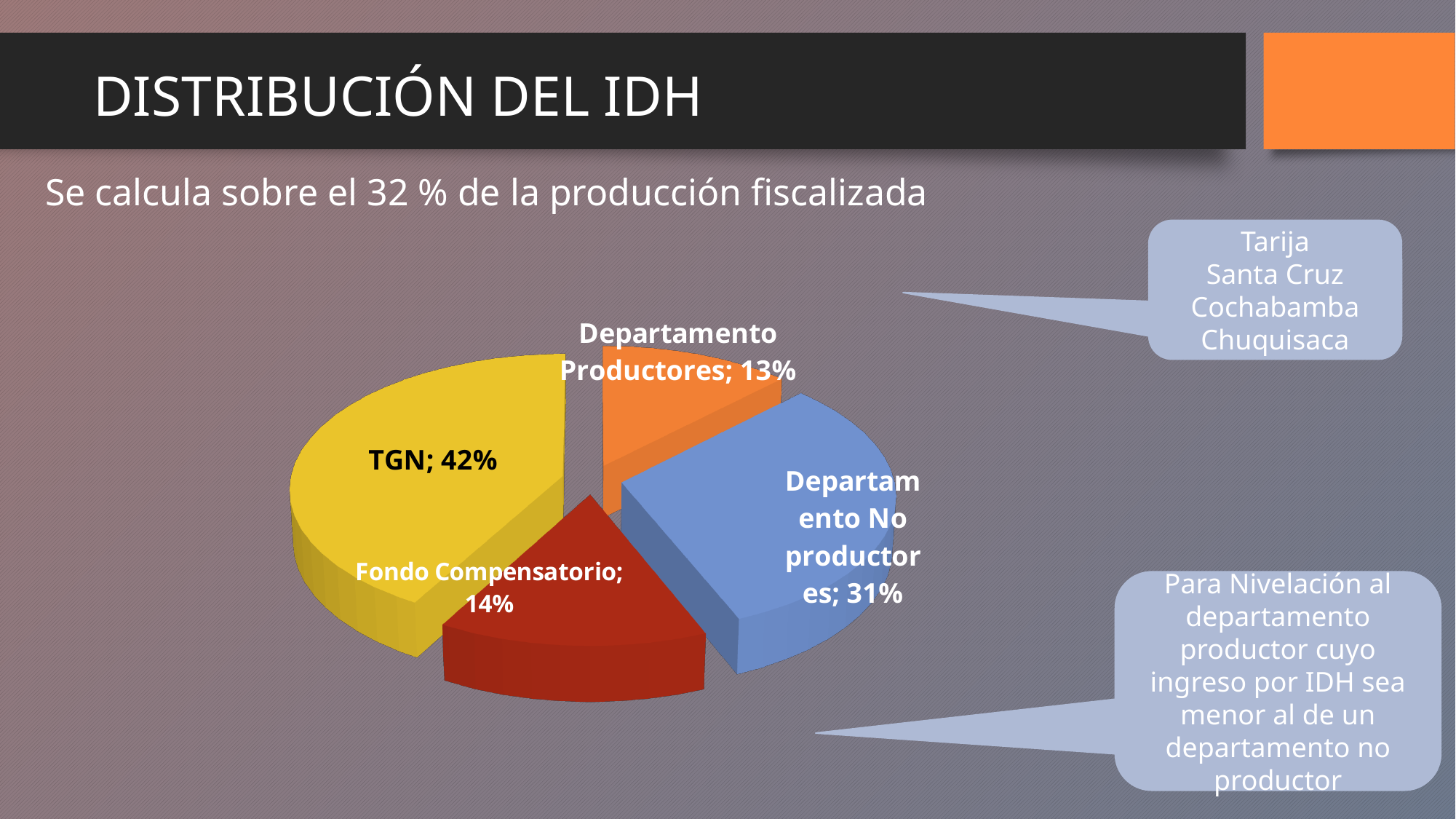
How many slices does the pie chart have? 4 What colour is the Departamento No productores slice? Blue What kind of chart is shown on the slide? Pie chart What colour is the TGN slice? Yellow What share of the pie does TGN have? 42% What share of the pie does Departamento Productores have? 13% Which is larger, the share for Fondo Compensatorio or the share for Departamento Productores? Fondo Compensatorio What share of the pie does Fondo Compensatorio have? 14% Which slice of the pie is the largest? TGN What is the difference between the TGN share and the Departamento No productores share? 11% Which slice of the pie is the smallest? Departamento Productores What share of the pie does Departamento No productores have? 31%